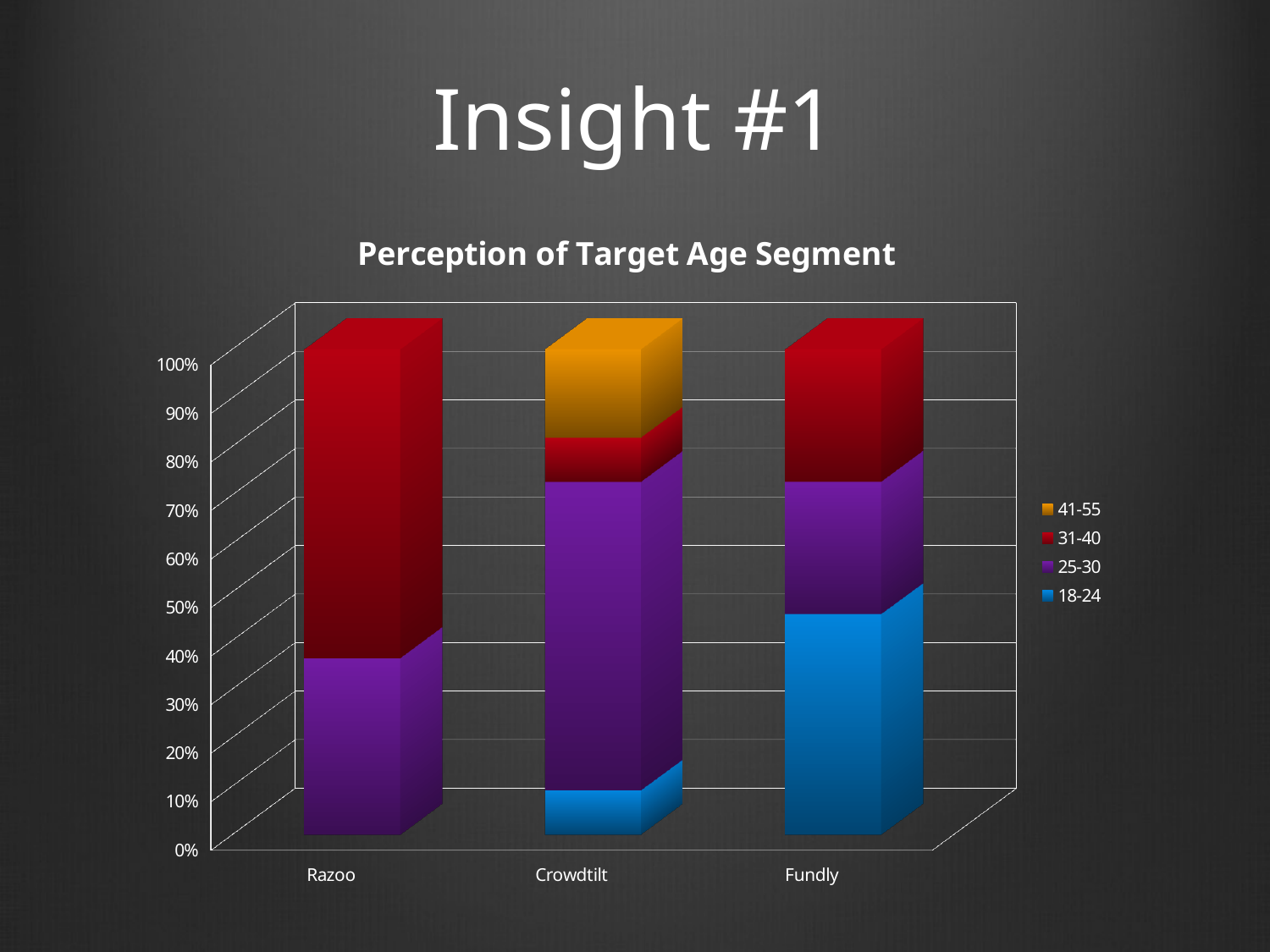
Which is larger: the 25-30 share for Crowdtilt or the 25-30 share for Razoo? Crowdtilt Which category has the largest 18-24 segment? Fundly How many categories are shown on the x axis of the chart? 3 Which category is the only one with a 41-55 segment in its bar? Crowdtilt Which colour represents the 41-55 age segment in the chart? Orange Which category has the largest 25-30 segment? Crowdtilt Is the 18-24 share for Crowdtilt greater or less than 20%? less Is the 31-40 share for Razoo greater or less than 50%? greater Is the 18-24 share for Fundly greater or less than 30%? greater How many series does the chart's legend list? 4 What kind of chart is shown on the slide? Stacked bar chart What is the title of the chart? Perception of Target Age Segment